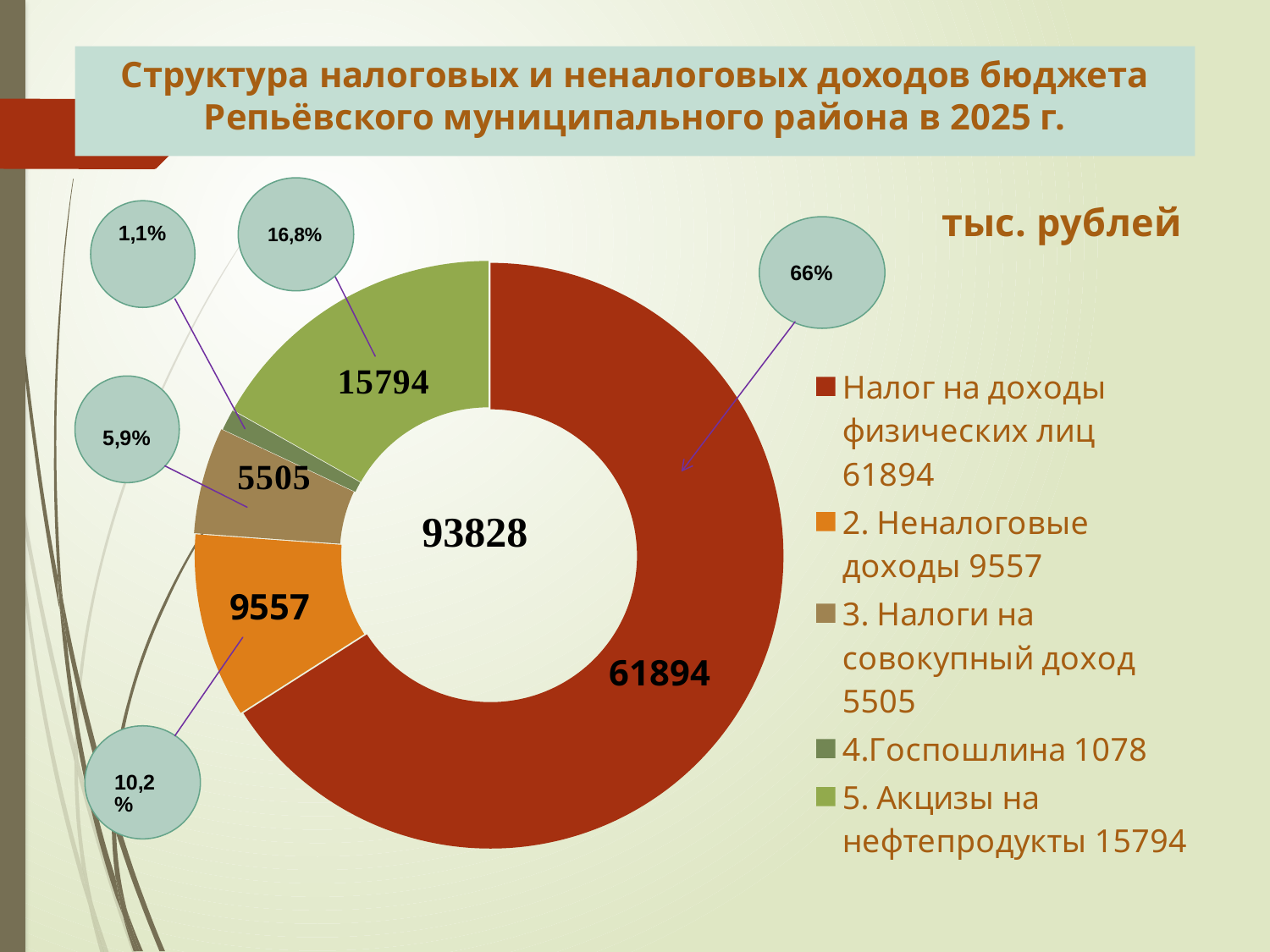
Which category has the smallest value? Госпошлина What is the value for Госпошлина? 1078 How many categories does the chart show? 5 What is the value for Налог на доходы физических лиц? 61894 What type of chart is shown on the slide? doughnut chart What is the value for Неналоговые доходы? 9557 Which is larger, Налоги на совокупный доход or Неналоговые доходы? Неналоговые доходы What is the difference between Акцизы на нефтепродукты and Неналоговые доходы? 6237 What is the value for Акцизы на нефтепродукты? 15794 What share of the total does Налог на доходы физических лиц represent, as labelled on the slide? 66% Which category has the largest value? Налог на доходы физических лиц What is the value for Налоги на совокупный доход? 5505